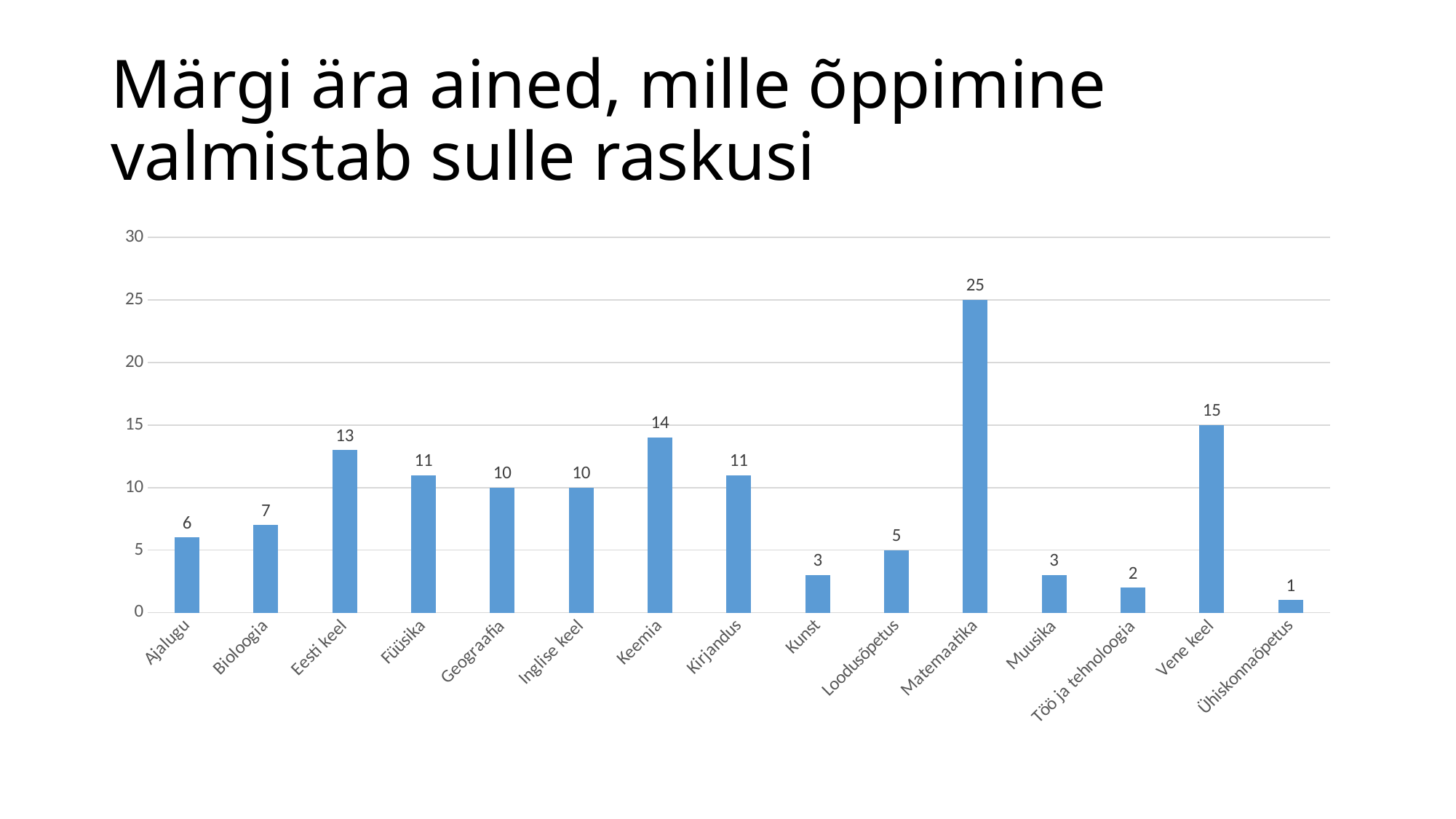
What is the value for Eesti keel? 13 Is the value for Vene keel greater or less than 10? greater Which subject has the highest value? Matemaatika What kind of chart is shown on the slide? bar chart Which subject has the lowest value? Ühiskonnaõpetus What is the value for Matemaatika? 25 What is the title of the slide? Märgi ära ained, mille õppimine valmistab sulle raskusi What is the difference between the values for Matemaatika and Vene keel? 10 Which is larger, the value for Keemia or the value for Kirjandus? Keemia How many subjects are shown on the x axis? 15 What is the value for Loodusõpetus? 5